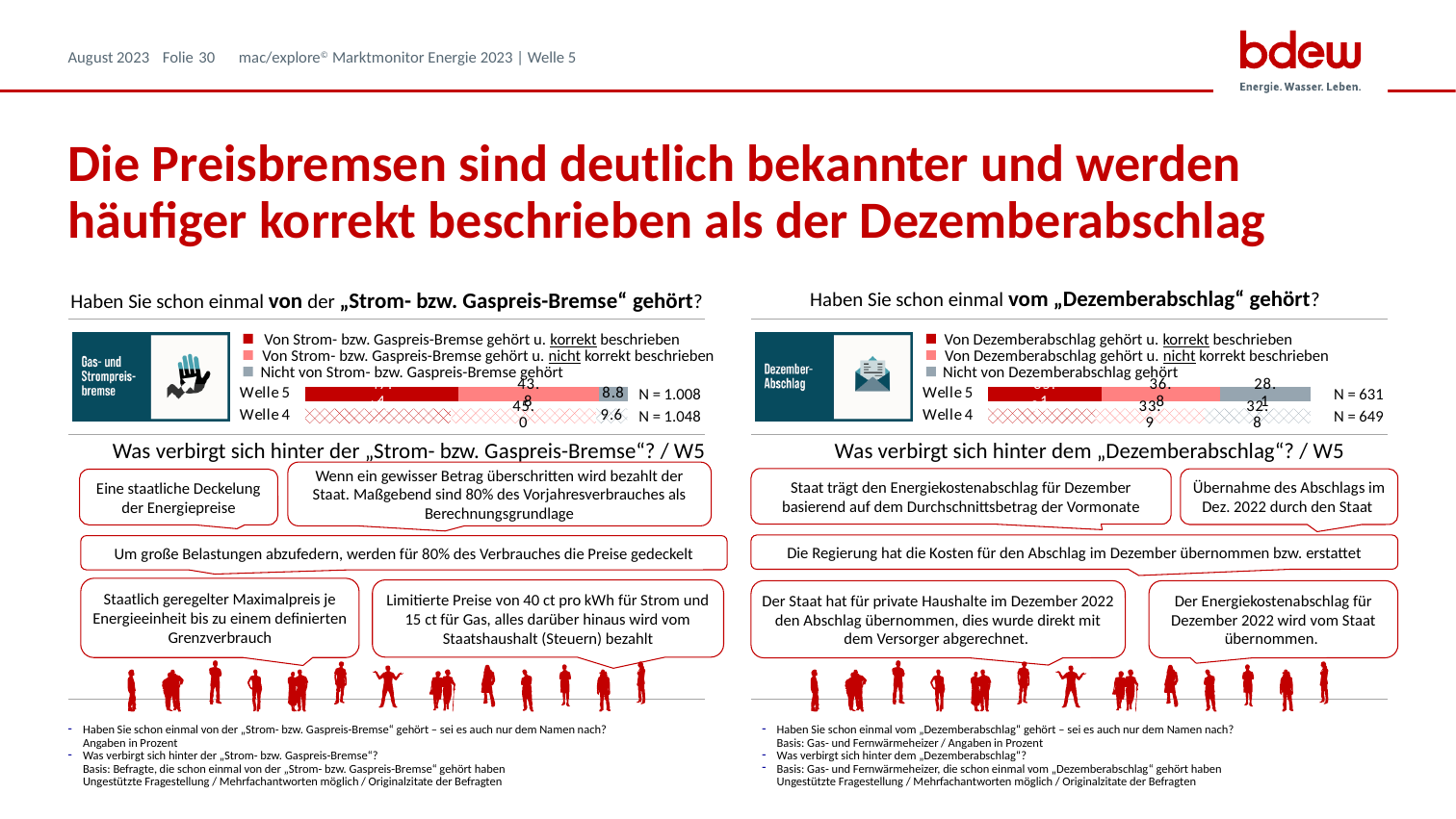
In the right chart (Dezemberabschlag), which wave has the larger share of "Nicht von Dezemberabschlag gehört", Welle 5 or Welle 4? Welle 4 What kind of chart is used on the left for "Haben Sie schon einmal von der „Strom- bzw. Gaspreis-Bremse“ gehört?"? Stacked bar chart In the right chart (Dezemberabschlag), what is the value for "Nicht von Dezemberabschlag gehört" in Welle 5? 28.1 In the left chart (Strom- bzw. Gaspreis-Bremse), which wave has the larger share of "Nicht von Strom- bzw. Gaspreis-Bremse gehört", Welle 5 or Welle 4? Welle 4 In the right chart (Dezemberabschlag), how many series does the legend list? 3 In the left chart (Strom- bzw. Gaspreis-Bremse), what is the N for Welle 5? N = 1.008 In the left chart (Strom- bzw. Gaspreis-Bremse), what is the value for "Nicht von Strom- bzw. Gaspreis-Bremse gehört" in Welle 5? 8.8 In the left chart (Strom- bzw. Gaspreis-Bremse), how many bars (waves) are shown? 2 In the left chart (Strom- bzw. Gaspreis-Bremse), how many series does the legend list? 3 In the left chart (Strom- bzw. Gaspreis-Bremse), what is the value for "Nicht von Strom- bzw. Gaspreis-Bremse gehört" in Welle 4? 9.6 In the left chart (Strom- bzw. Gaspreis-Bremse), what is the difference between the "Nicht ... gehört" values of Welle 4 and Welle 5? 0.8 In the right chart (Dezemberabschlag), what is the N for Welle 4? N = 649